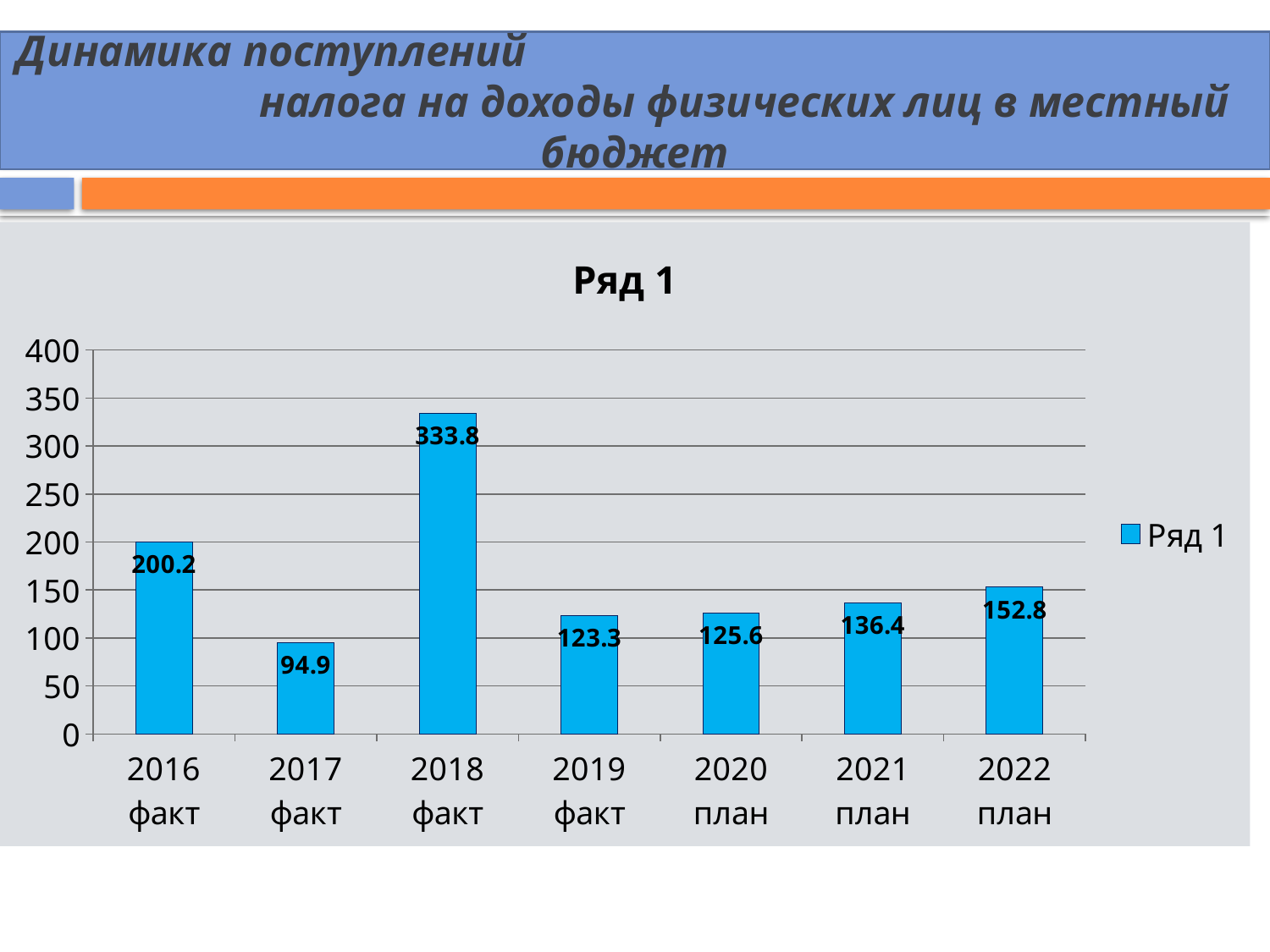
Which category has the lowest value? 2017 факт What is the value for 2018 факт? 333.8 What is the value for 2021 план? 136.4 Is the value for 2019 факт greater or less than 150? less Which category has the highest value? 2018 факт What is the value for 2017 факт? 94.9 What kind of chart is shown on the slide? bar chart What is the difference between the values for 2018 факт and 2016 факт? 133.6 Which is larger, the value for 2016 факт or the value for 2022 план? 2016 факт What is the difference between the values for 2022 план and 2021 план? 16.4 How many categories are shown on the x axis? 7 Do the values rise or fall from 2019 факт to 2022 план? rise